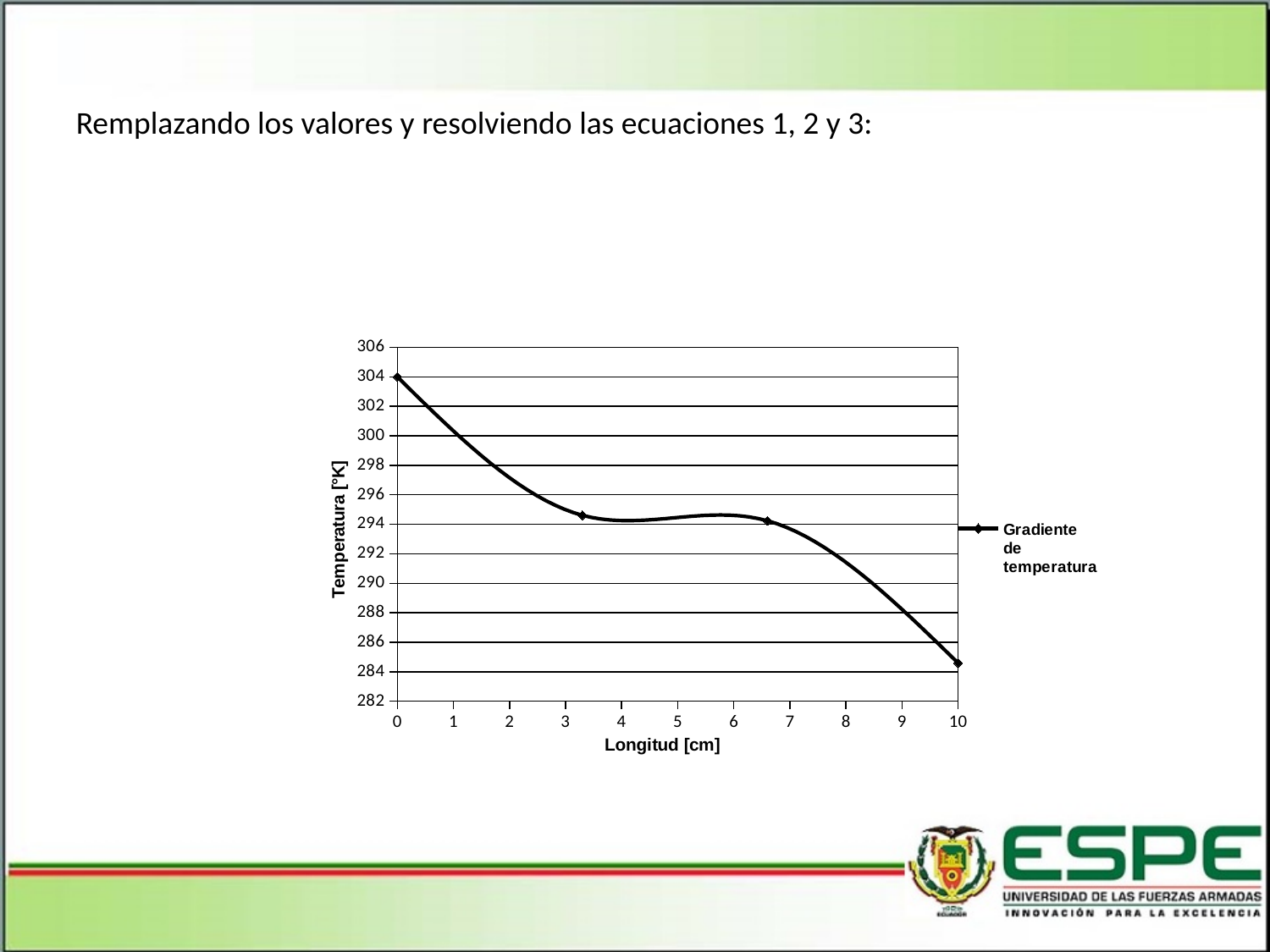
At which length on the x axis is the temperature lowest? 10 What is the name of the series shown in the legend? Gradiente de temperatura At which length on the x axis is the temperature highest? 0 What is the title of the x axis? Longitud [cm] Is the temperature at a length of 10 cm greater or less than 286? less How many series does the legend list? 1 How many data points are plotted on the line? 4 Is the temperature at a length of 0 cm greater or less than 300? greater Do the temperature values rise or fall as the length increases along the x axis? fall What kind of chart is shown on the slide? line chart Which has the higher temperature, the point at 0 cm or the point at 10 cm? 0 cm Is the temperature at the point near 3 cm greater or less than 292? greater